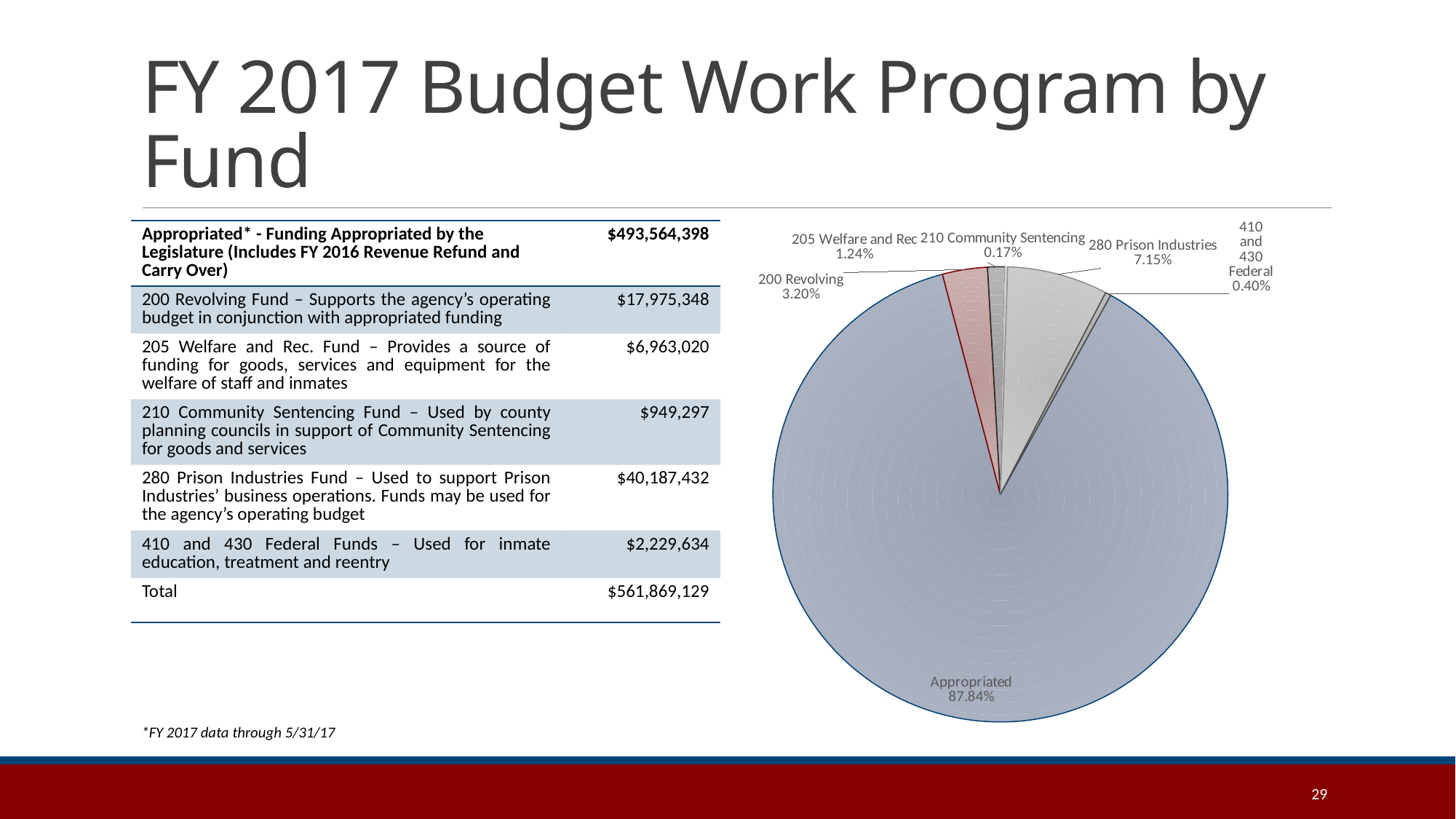
What percentage is shown for 205 Welfare and Rec in the pie chart? 1.24% How many slices does the pie chart have? 6 What colour is the 205 Welfare and Rec slice in the pie chart? red What share of the pie does the Appropriated slice represent? 87.84% Which slice of the pie chart is the largest? Appropriated What percentage is shown for 280 Prison Industries in the pie chart? 7.15% Which has the larger share in the pie chart, 280 Prison Industries or 200 Revolving? 280 Prison Industries What percentage is shown for 410 and 430 Federal in the pie chart? 0.40% What percentage is shown for 200 Revolving in the pie chart? 3.20% What is the difference in percentage points between the Appropriated slice and the 280 Prison Industries slice? 80.69% What kind of chart is shown on the slide? pie chart Which slice of the pie chart is the smallest? 210 Community Sentencing